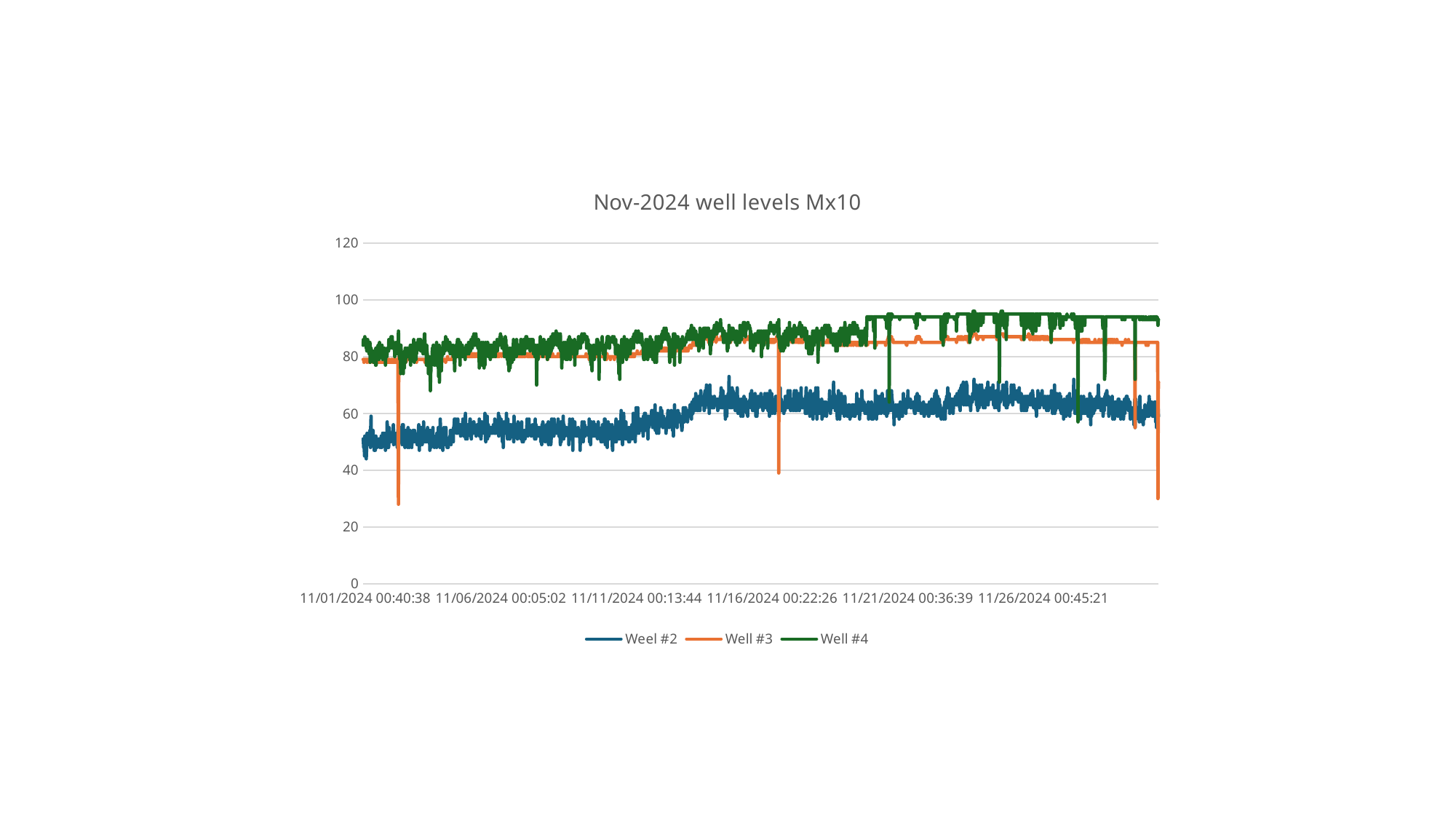
Is the value for Well #3 around 11/11/2024 greater or less than 60? greater Does the Well #3 series generally rise or fall over the month, ignoring the brief dips? rise Is the value for Well #4 at the end of the month (around 11/26/2024) greater or less than 80? greater Is the value for Weel #2 at the start of the month (around 11/01/2024) greater or less than 60? less Which series is higher, Well #4 or Weel #2? Well #4 What kind of chart is shown on the slide? line chart How many series does the legend list? 3 Which series has the lowest values throughout the month? Weel #2 What is the title of the chart? Nov-2024 well levels Mx10 Which series reaches the highest values on the chart? Well #4 Which series is plotted in orange? Well #3 Does the Weel #2 series generally rise or fall from the start to the end of November? rise